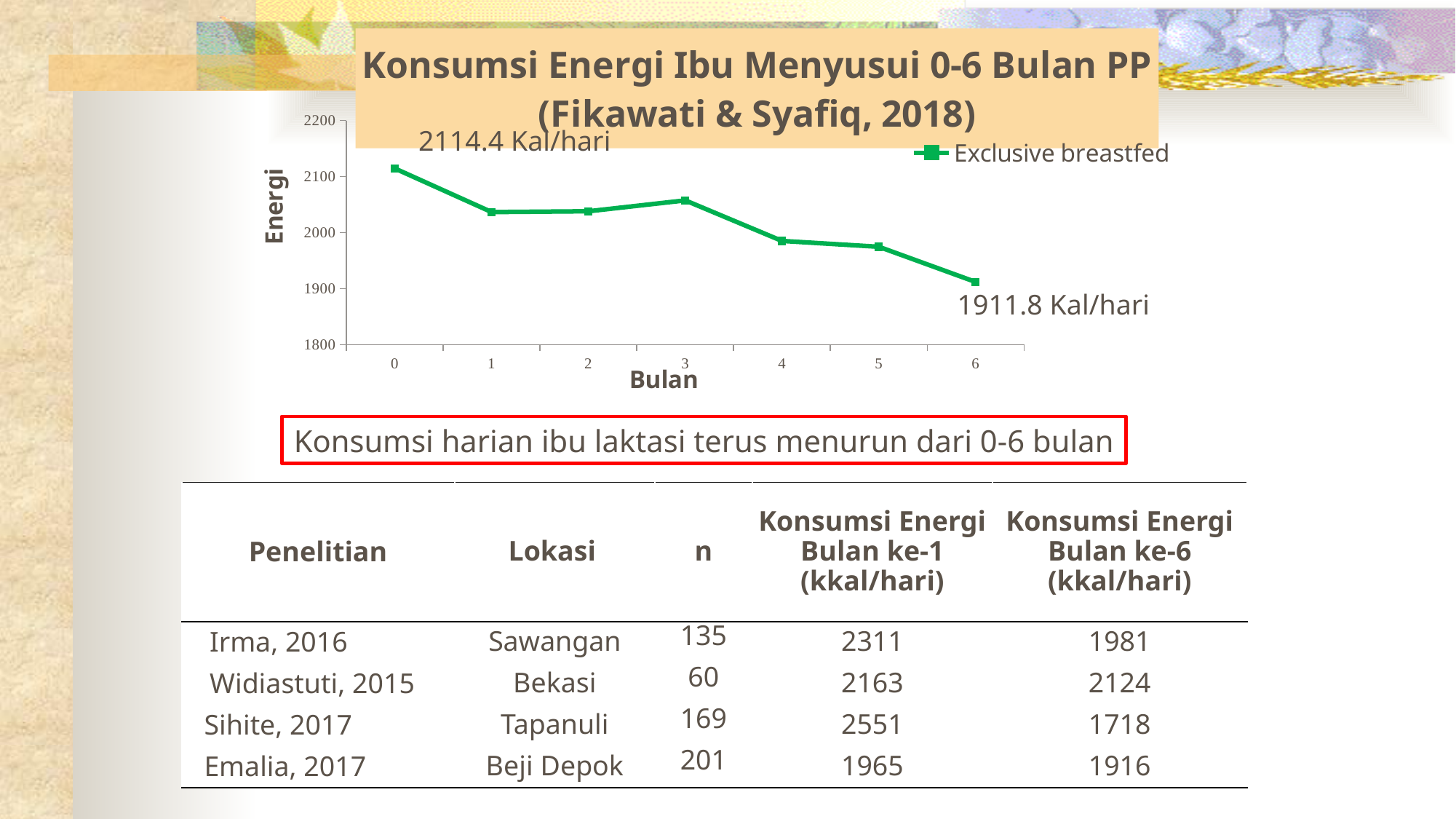
Is the value for month 3 greater or less than 2000? greater Do the energy consumption values generally rise or fall from month 0 to month 6? Fall What is the name of the series shown in the legend? Exclusive breastfed What is the energy consumption value shown at month 6 on the chart? 1911.8 Kal/hari How many series does the legend list? 1 By how much does the energy consumption at month 0 exceed that at month 6? 202.6 Kal/hari What is the energy consumption value shown at month 0 on the chart? 2114.4 Kal/hari At which month is the energy consumption lowest? 6 At which month is the energy consumption highest? 0 What kind of chart is shown on the slide? Line chart How many data points are plotted on the line? 7 Is the value for month 5 greater or less than 2000? less